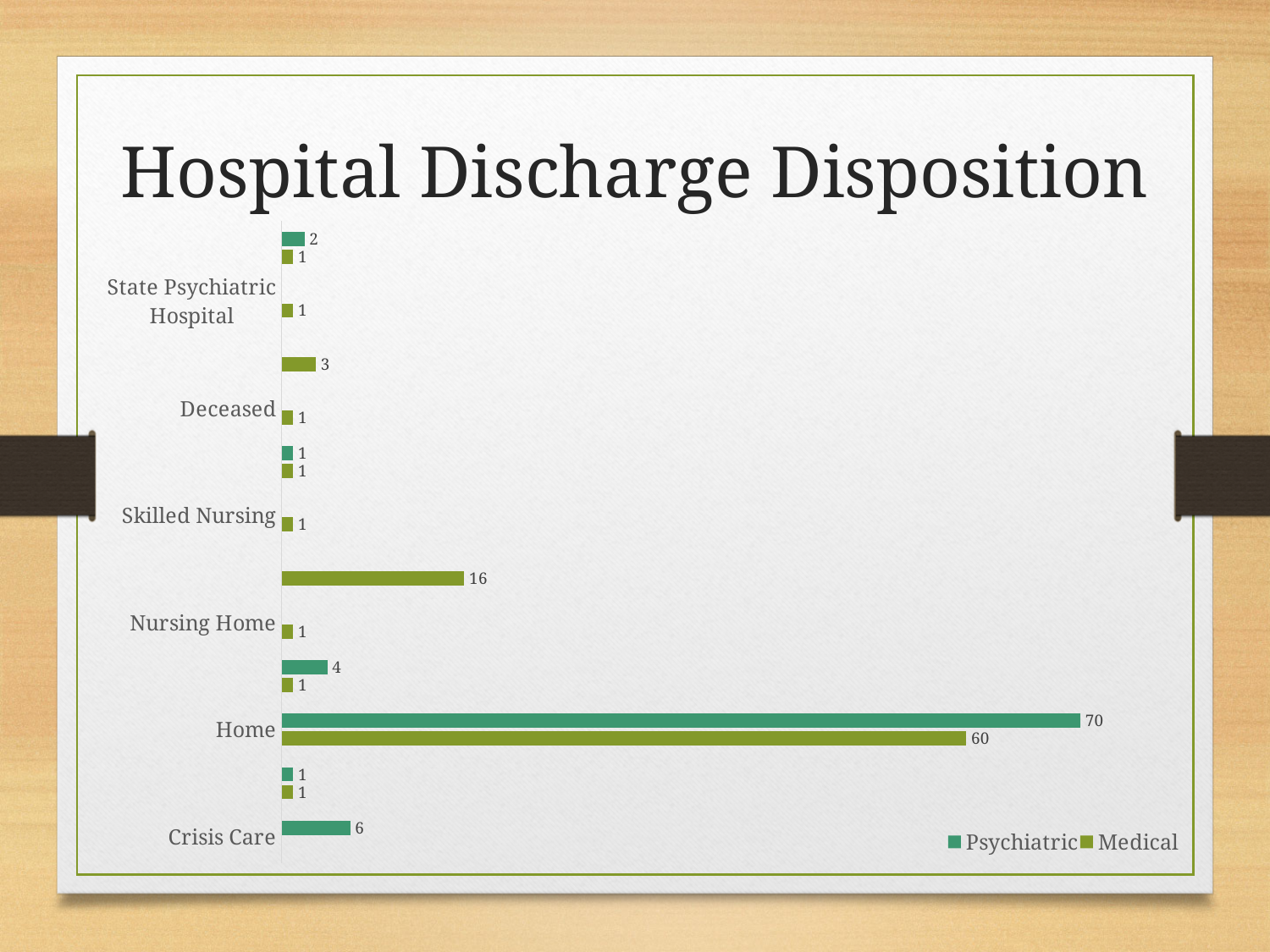
What is the Medical value for Home? 60 What are the two series named in the legend? Psychiatric and Medical Which category has the highest Psychiatric value? Home For Home, which series has the larger value, Psychiatric or Medical? Psychiatric What type of chart is shown on the slide? Bar chart What is the title of the chart? Hospital Discharge Disposition Which is larger: the Psychiatric value for Crisis Care or the Psychiatric value for Home? Home What is the difference between the Psychiatric and Medical values for Home? 10 Which category has the highest Medical value? Home What is the Psychiatric value for Home? 70 What is the Psychiatric value for Crisis Care? 6 How many series does the legend list? 2